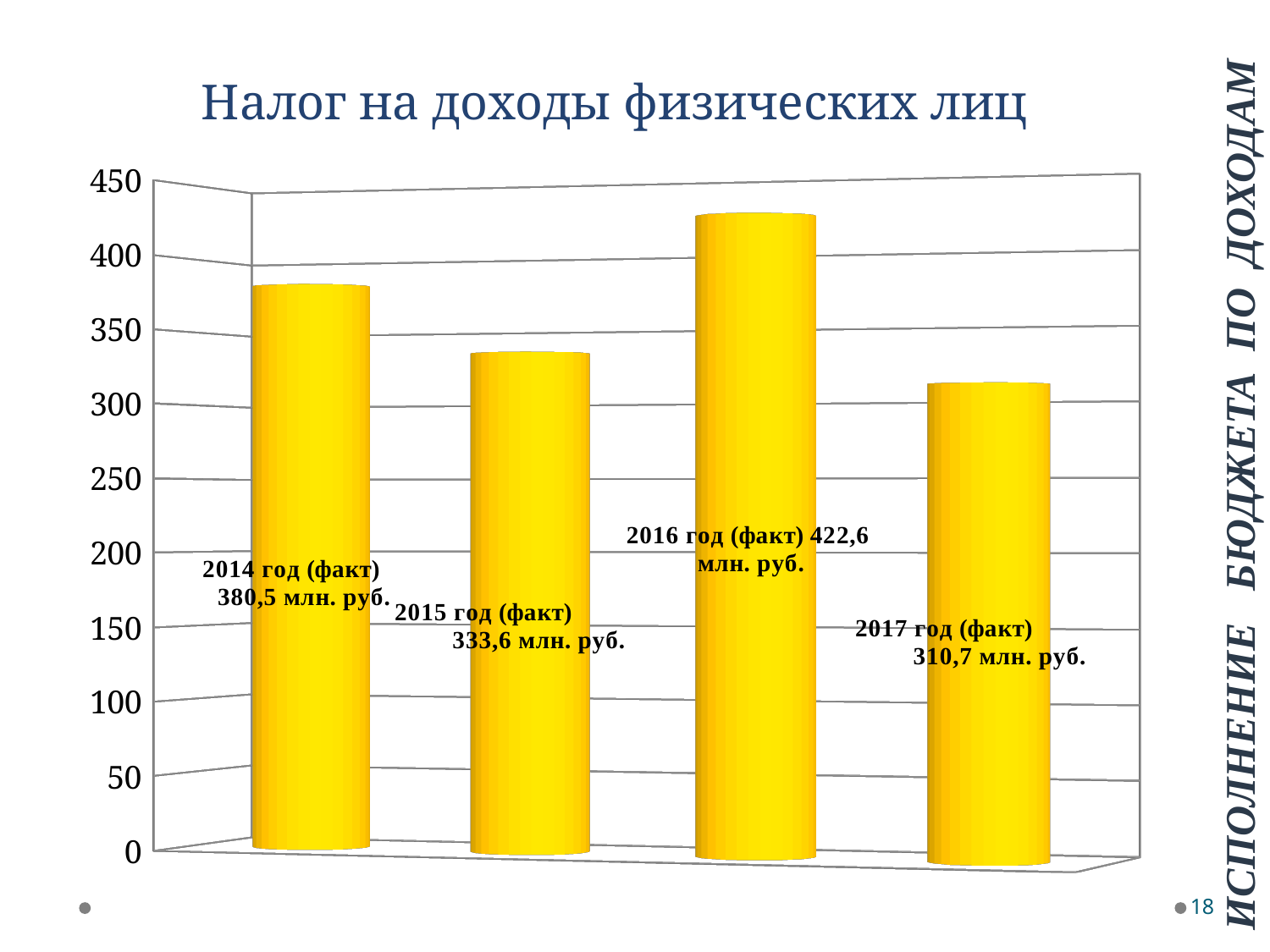
What is the value for 2014 год (факт)? 380,5 млн. руб. What is the title of the chart? Налог на доходы физических лиц What is the difference between the values for 2016 and 2014? 42,1 млн. руб. What is the difference between the values for 2015 and 2017? 22,9 млн. руб. What is the value for 2016 год (факт)? 422,6 млн. руб. What is the value for 2017 год (факт)? 310,7 млн. руб. What is the value for 2015 год (факт)? 333,6 млн. руб. Is the value for 2016 greater or less than 400? greater Which year has the highest value? 2016 год (факт) Which year has the lowest value? 2017 год (факт) How many bars are shown in the chart? 4 Which is larger, the value for 2014 or the value for 2015? 2014